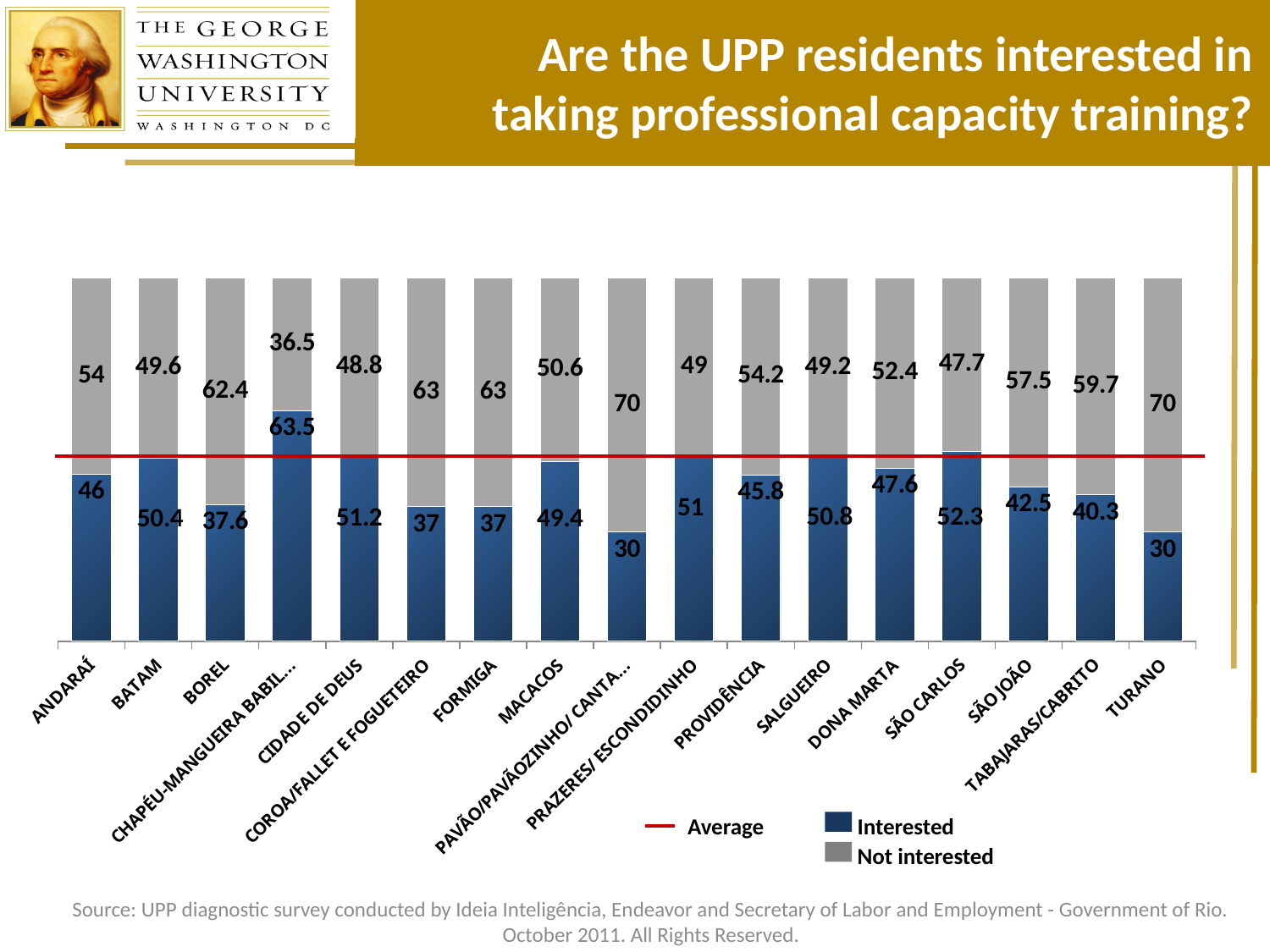
What is the difference between the 'Not interested' and 'Interested' values for TURANO? 40 What type of chart is shown on the slide? Stacked bar chart How many communities are shown on the x axis? 17 What is the 'Interested' value for SÃO CARLOS? 52.3 Which is larger: the 'Interested' value for BATAM or the 'Interested' value for TABAJARAS/CABRITO? BATAM Which community has the lowest 'Not interested' value? CHAPÉU-MANGUEIRA BABIL... How many entries does the legend list? 3 What percentage of residents in BOREL are interested in professional capacity training? 37.6 What is the total of the stacked bar for ANDARAÍ? 100 Which community has the highest 'Interested' value? CHAPÉU-MANGUEIRA BABIL... What is the 'Not interested' value for SÃO JOÃO? 57.5 What is the difference between the 'Not interested' and 'Interested' values for BOREL? 24.8